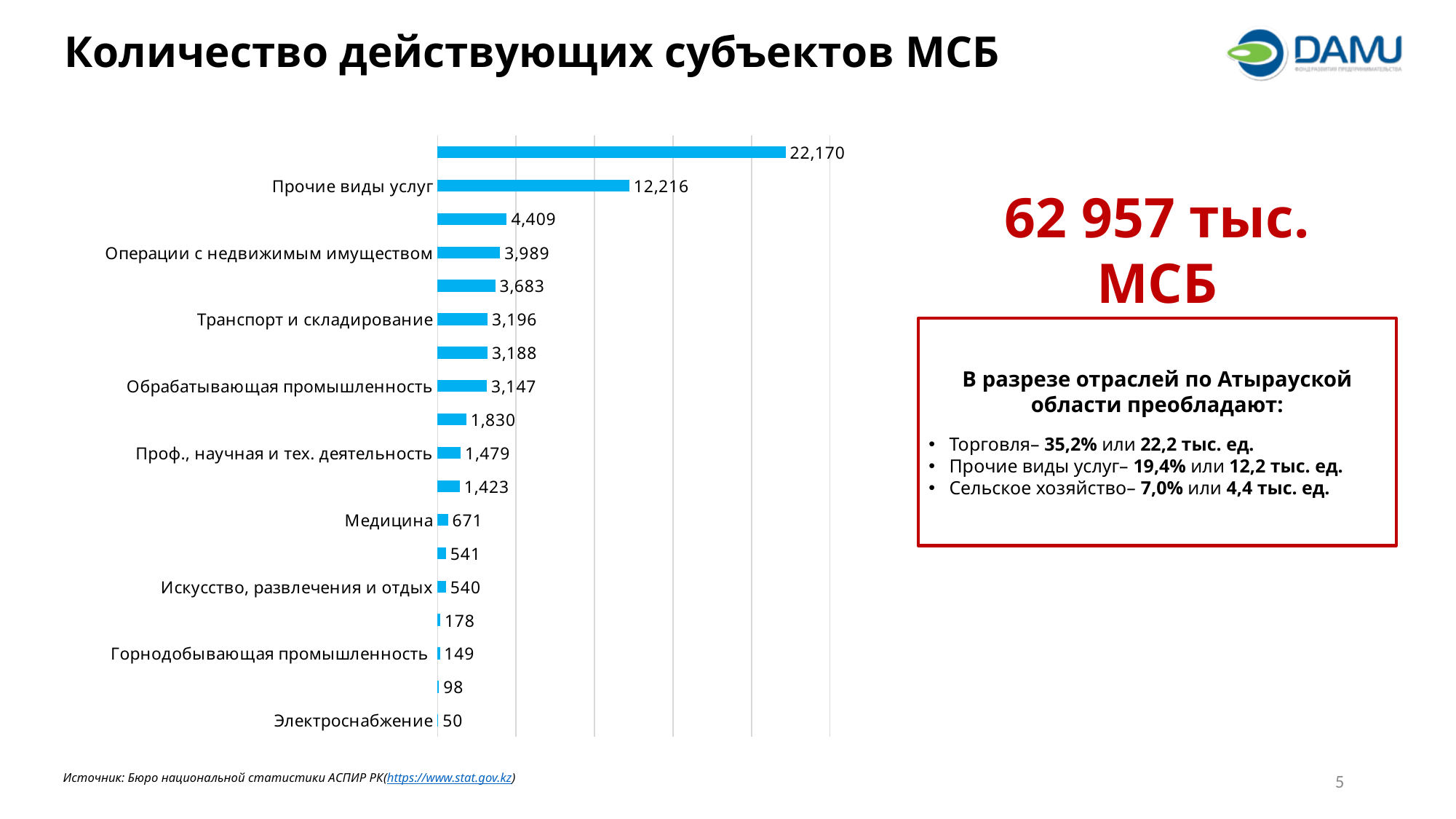
What is the difference between the values for Прочие виды услуг and Операции с недвижимым имуществом? 8,227 Which labelled category has the lowest value in the chart? Электроснабжение What is the value for Операции с недвижимым имуществом? 3,989 What is the value for Горнодобывающая промышленность? 149 What is the largest value shown in the chart? 22,170 What type of chart is shown on the slide? bar chart What is the value for Прочие виды услуг? 12,216 Which is larger, the value for Медицина or the value for Искусство, развлечения и отдых? Медицина What is the title of the slide containing the chart? Количество действующих субъектов МСБ What is the value for Медицина? 671 How many bars are plotted in the chart? 18 What is the value for Транспорт и складирование? 3,196